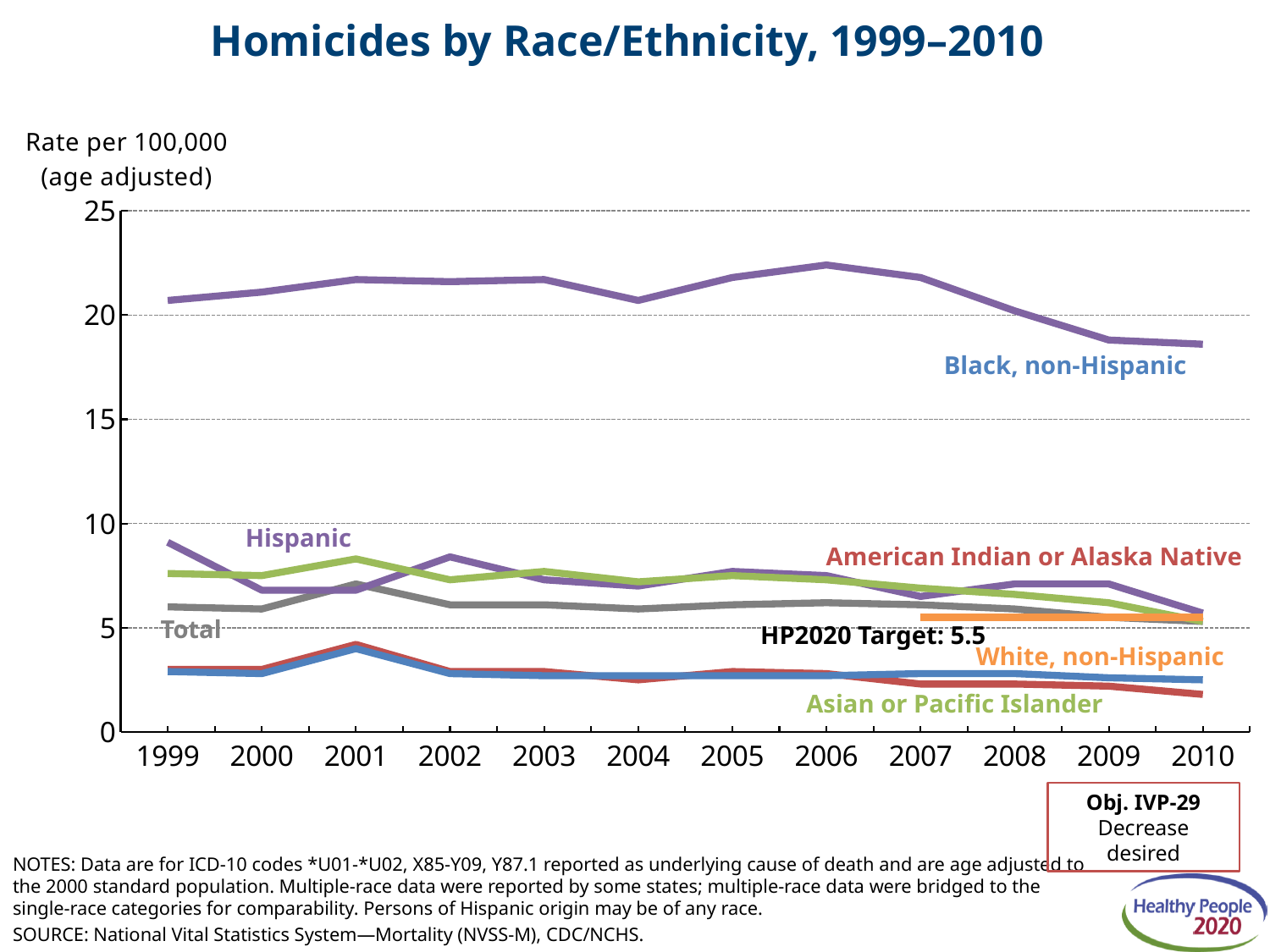
Does the Black, non-Hispanic rate rise or fall from 2006 to 2010? Fall Is the value for Asian or Pacific Islander in 2010 greater or less than 5? less What is the HP2020 Target value shown on the chart? 5.5 What kind of chart is shown on the slide? Line chart How many race/ethnicity series (including Total) are plotted on the chart? 6 Which group has the lowest homicide rate in 2010? Asian or Pacific Islander Which group has the highest homicide rate across all years shown? Black, non-Hispanic Is the value for Black, non-Hispanic in 2010 greater or less than 20? less How many years are shown along the x axis? 12 Is the value for Black, non-Hispanic in 2006 greater or less than 20? greater What is the title of the chart? Homicides by Race/Ethnicity, 1999–2010 In 1999, which is larger: the Hispanic rate or the Total rate? Hispanic